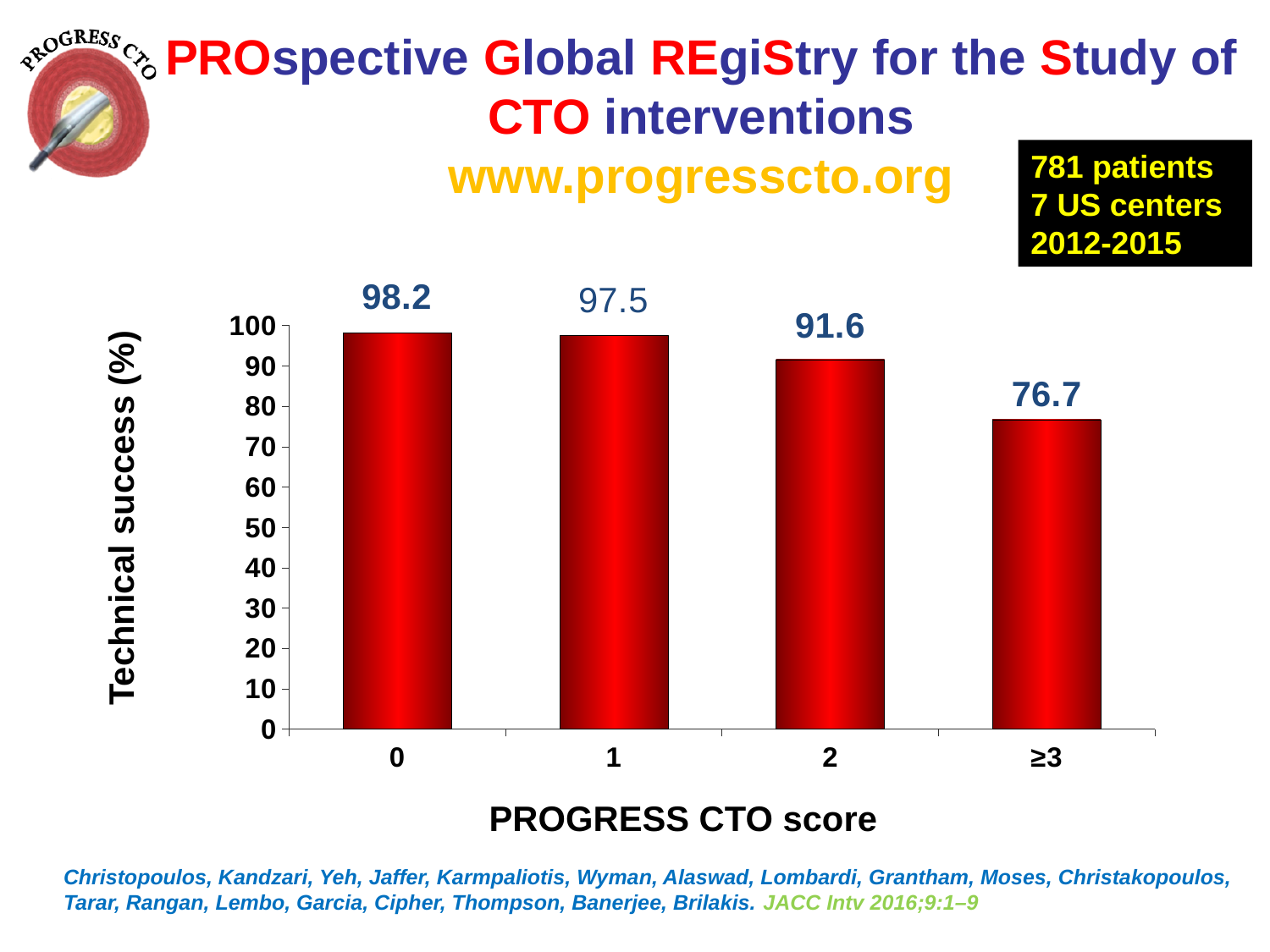
Does technical success rise or fall as the PROGRESS CTO score increases along the x axis? Fall How many PROGRESS CTO score categories are shown on the chart? 4 Which PROGRESS CTO score has the lowest technical success? ≥3 What kind of chart is shown on the slide? Bar chart What is the technical success (%) for a PROGRESS CTO score of 2? 91.6 What is the difference in technical success (%) between a PROGRESS CTO score of 2 and a score of ≥3? 14.9 What is the technical success (%) for a PROGRESS CTO score of ≥3? 76.7 Which PROGRESS CTO score has the highest technical success? 0 What is the difference in technical success (%) between a PROGRESS CTO score of 0 and a score of ≥3? 21.5 What is the technical success (%) for a PROGRESS CTO score of 0? 98.2 Which has a higher technical success: a PROGRESS CTO score of 1 or a score of 2? 1 What is the technical success (%) for a PROGRESS CTO score of 1? 97.5